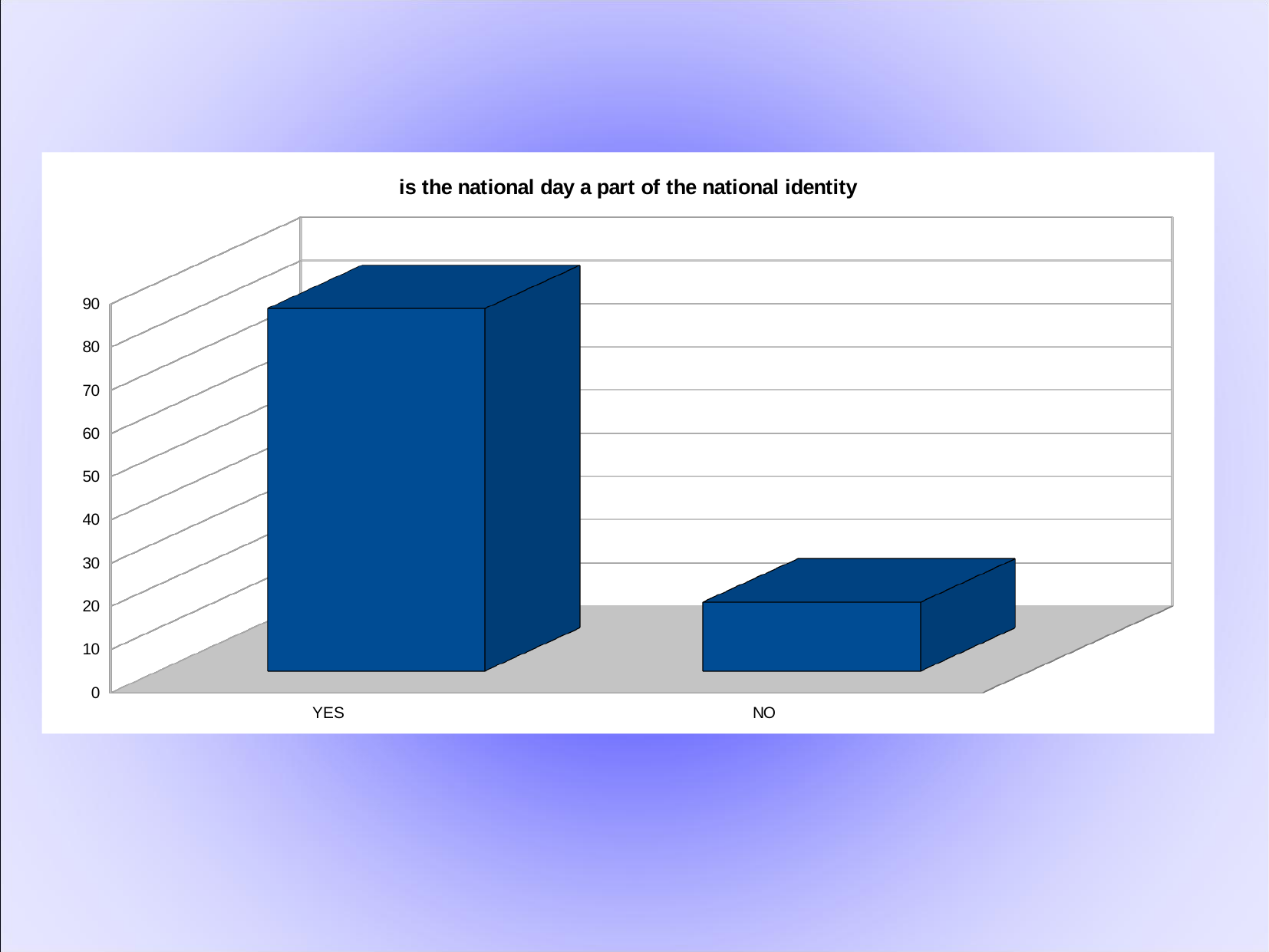
What is the title of the chart? is the national day a part of the national identity What kind of chart is shown on the slide? bar chart Which is larger, the value for YES or the value for NO? YES Which category has the lowest value? NO Do the values fall or rise from YES to NO along the x axis? fall Is the value for YES greater or less than 50? greater Is the value for NO greater or less than 40? less Which category has the highest value? YES What are the two category labels on the x axis? YES and NO How many categories are shown on the x axis? 2 Is the value for NO greater or less than 50? less